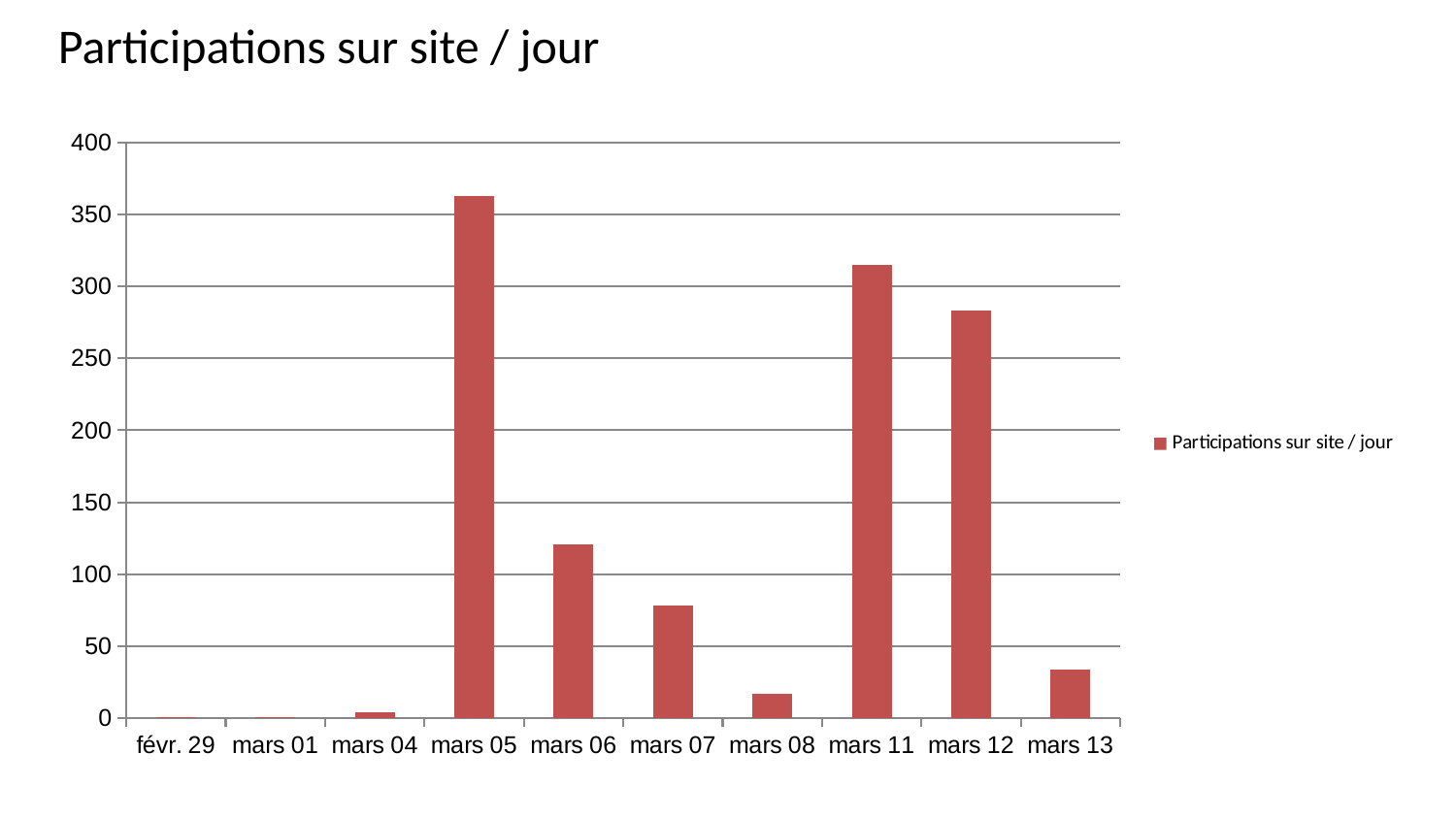
Is the value for mars 06 greater or less than 100? greater What is the title of the chart? Participations sur site / jour Is the value for mars 11 greater or less than 300? greater Is the value for mars 13 greater or less than 50? less How many series does the legend list? 1 Which date has the highest number of participations? mars 05 How many dates are shown on the x axis of the chart? 10 What kind of chart is shown on the slide? bar chart Which has the larger value, mars 11 or mars 12? mars 11